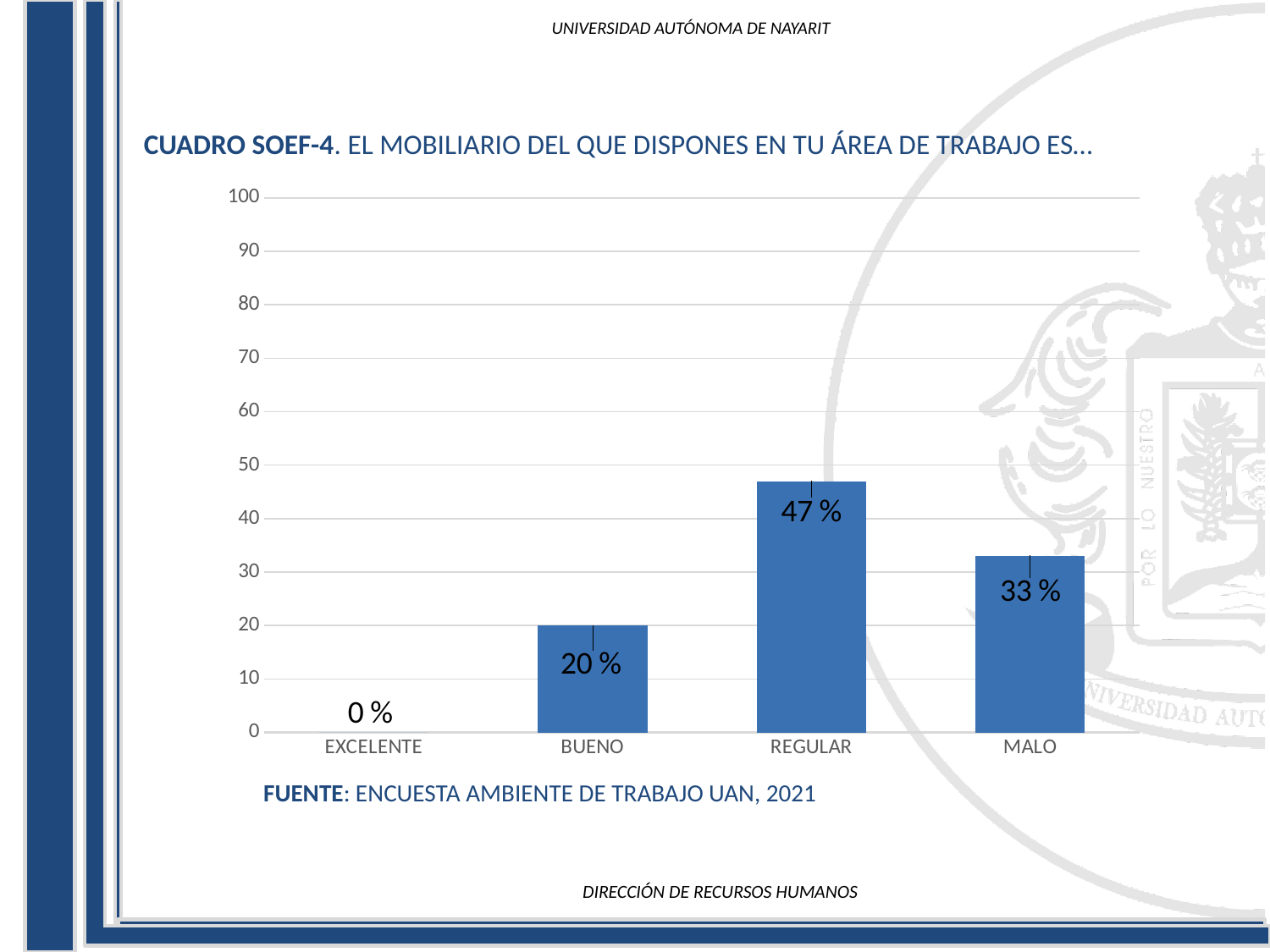
What is the difference between the values for REGULAR and MALO? 14 % Which category has the highest value? REGULAR What kind of chart is shown? bar chart What is the value for MALO? 33 % Is the value for REGULAR greater or less than 50? less Which category has the lowest value? EXCELENTE What is the value for REGULAR? 47 % How many categories are shown on the x axis? 4 What is the source cited below the chart? ENCUESTA AMBIENTE DE TRABAJO UAN, 2021 What is the value for BUENO? 20 % Which is larger, the value for BUENO or the value for MALO? MALO What is the value for EXCELENTE? 0 %